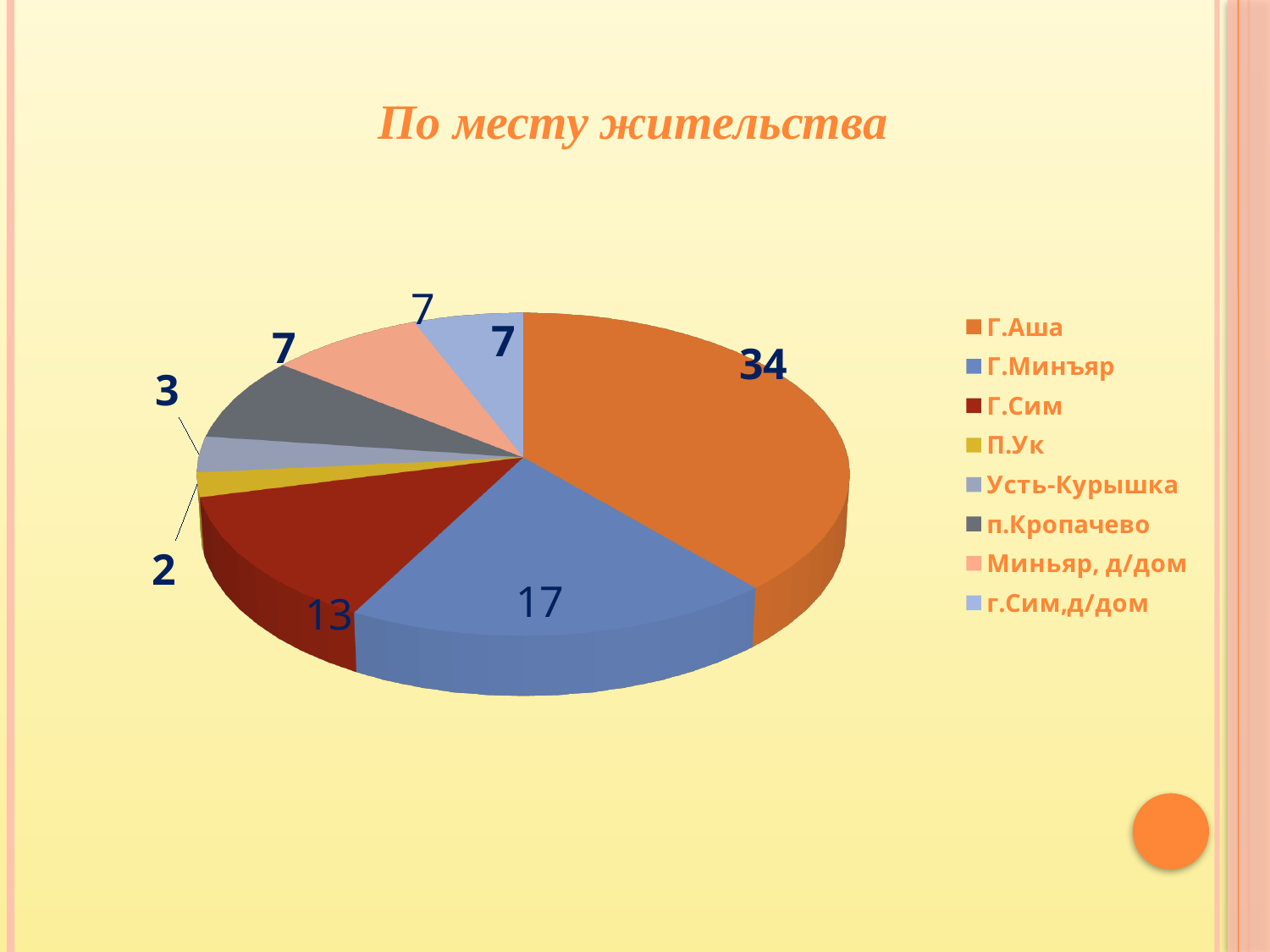
What is the title of the chart? По месту жительства What is the difference between the values for Г.Аша and Г.Минъяр? 17 What is the value for П.Ук? 2 How many categories does the legend list? 8 What is the value for Г.Минъяр? 17 Which category has the largest slice? Г.Аша What is the value for Усть-Курышка? 3 Which is larger, the value for Г.Сим or the value for п.Кропачево? Г.Сим Which category has the smallest slice? П.Ук What is the value for Г.Аша? 34 What is the value for Г.Сим? 13 What type of chart is shown on the slide? pie chart